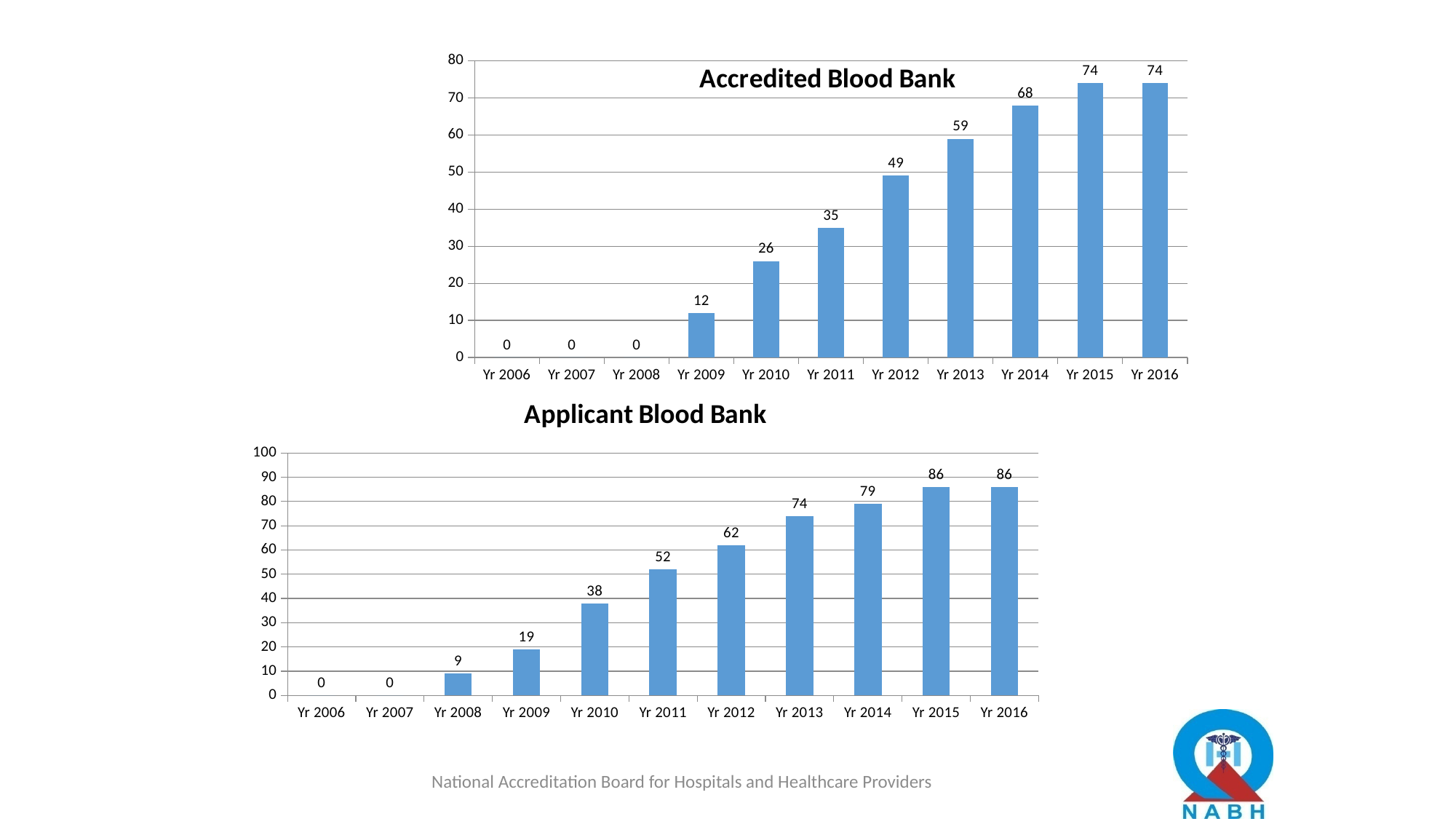
In the Accredited Blood Bank chart, which year first shows a non-zero value? Yr 2009 In the Applicant Blood Bank chart, do the values rise or fall from Yr 2008 to Yr 2015? rise In the Accredited Blood Bank chart, what is the value for Yr 2012? 49 How many years are shown on the x axis of the Accredited Blood Bank chart? 11 What kind of chart is the Applicant Blood Bank chart? bar chart In the Accredited Blood Bank chart, which is larger, the value for Yr 2011 or Yr 2010? Yr 2011 In the Applicant Blood Bank chart, what is the difference between the values for Yr 2012 and Yr 2011? 10 In the Accredited Blood Bank chart, what is the difference between the values for Yr 2014 and Yr 2013? 9 In the Applicant Blood Bank chart, what is the value for Yr 2010? 38 In the Applicant Blood Bank chart, what is the value for Yr 2008? 9 In the Applicant Blood Bank chart, is the value for Yr 2013 greater or less than 70? greater In the Accredited Blood Bank chart, what is the value for Yr 2016? 74